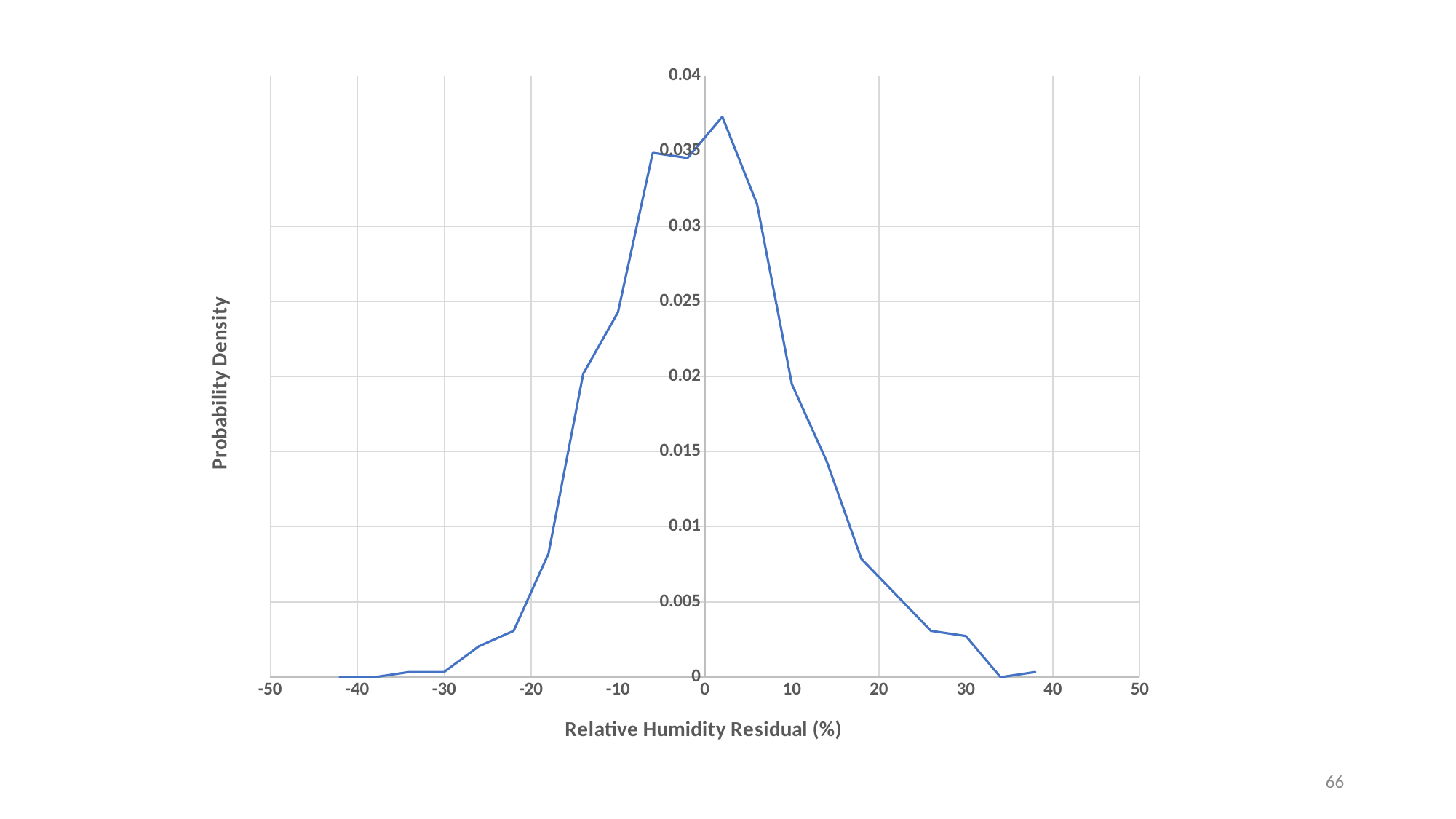
How many lines are plotted on the chart? 1 Is the value at a Relative Humidity Residual of 20 greater or less than 0.01? less What is the title of the x axis? Relative Humidity Residual (%) Is the peak value of the line greater or less than 0.035? greater What kind of chart is shown on the slide? line chart Is the value at a Relative Humidity Residual of -20 larger or smaller than the value at 0? smaller Is the value at a Relative Humidity Residual of -30 greater or less than 0.005? less What is the title of the y axis? Probability Density Does the line rise or fall as the Relative Humidity Residual goes from 10 to 30? fall Does the line rise or fall as the Relative Humidity Residual goes from -40 to 0? rise